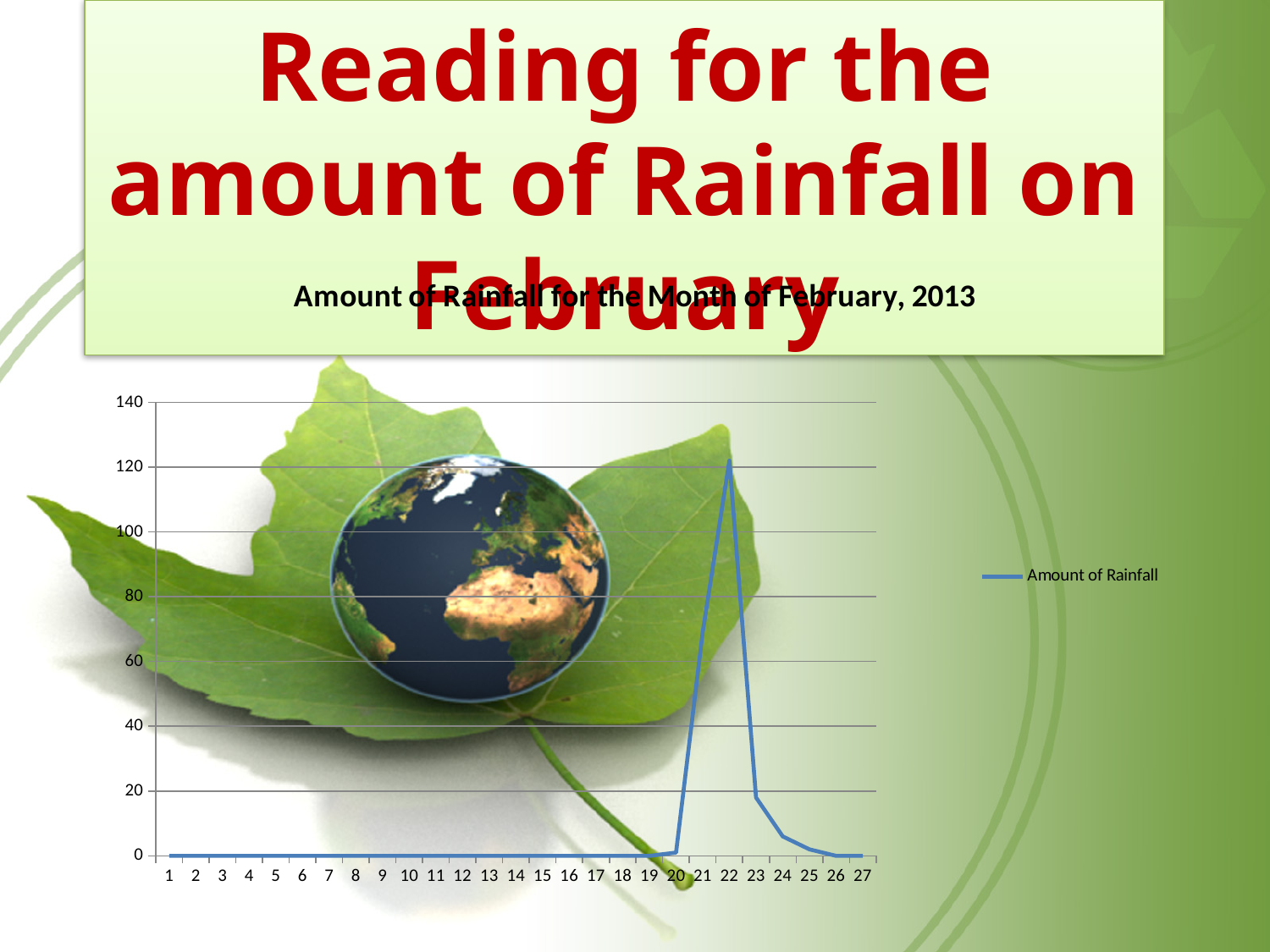
What is the title of the chart? Amount of Rainfall for the Month of February, 2013 What is the amount of rainfall on day 5? 0 Is the value for day 22 greater or less than 100? greater What is the name of the series shown in the legend? Amount of Rainfall How many series does the legend list? 1 What kind of chart is shown on the slide? line chart Is the value for day 21 greater or less than 20? greater Which day has the larger amount of rainfall, day 22 or day 23? 22 Is the value for day 23 greater or less than 40? less Do the values rise or fall from day 22 to day 27? fall How many days are plotted along the x axis? 27 On which day is the amount of rainfall highest? 22